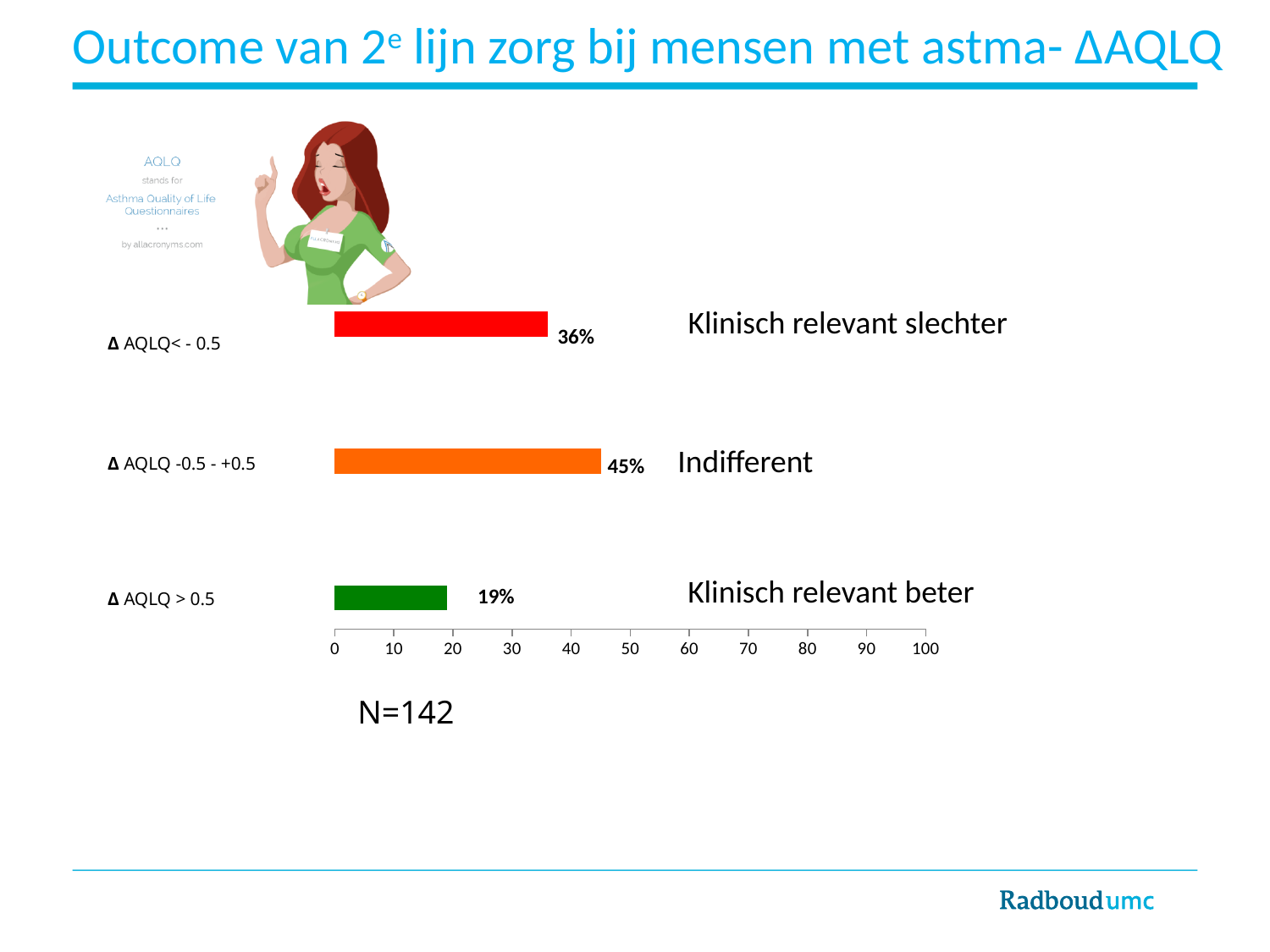
What is the difference between the values for Δ AQLQ -0.5 - +0.5 and Δ AQLQ < -0.5? 9% What is the sample size (N) stated below the chart? N=142 Which category has the highest value? Δ AQLQ -0.5 - +0.5 What is the difference between the values for Δ AQLQ < -0.5 and Δ AQLQ > 0.5? 17% What is the value for Δ AQLQ > 0.5? 19% What is the value for Δ AQLQ -0.5 - +0.5? 45% Which category has the lowest value? Δ AQLQ > 0.5 What is the value for Δ AQLQ < -0.5? 36% Is the value for Δ AQLQ -0.5 - +0.5 greater or less than 40? greater How many categories are shown in the chart? 3 Which is larger, the value for Δ AQLQ < -0.5 or the value for Δ AQLQ > 0.5? Δ AQLQ < -0.5 What kind of chart is shown on the slide? bar chart